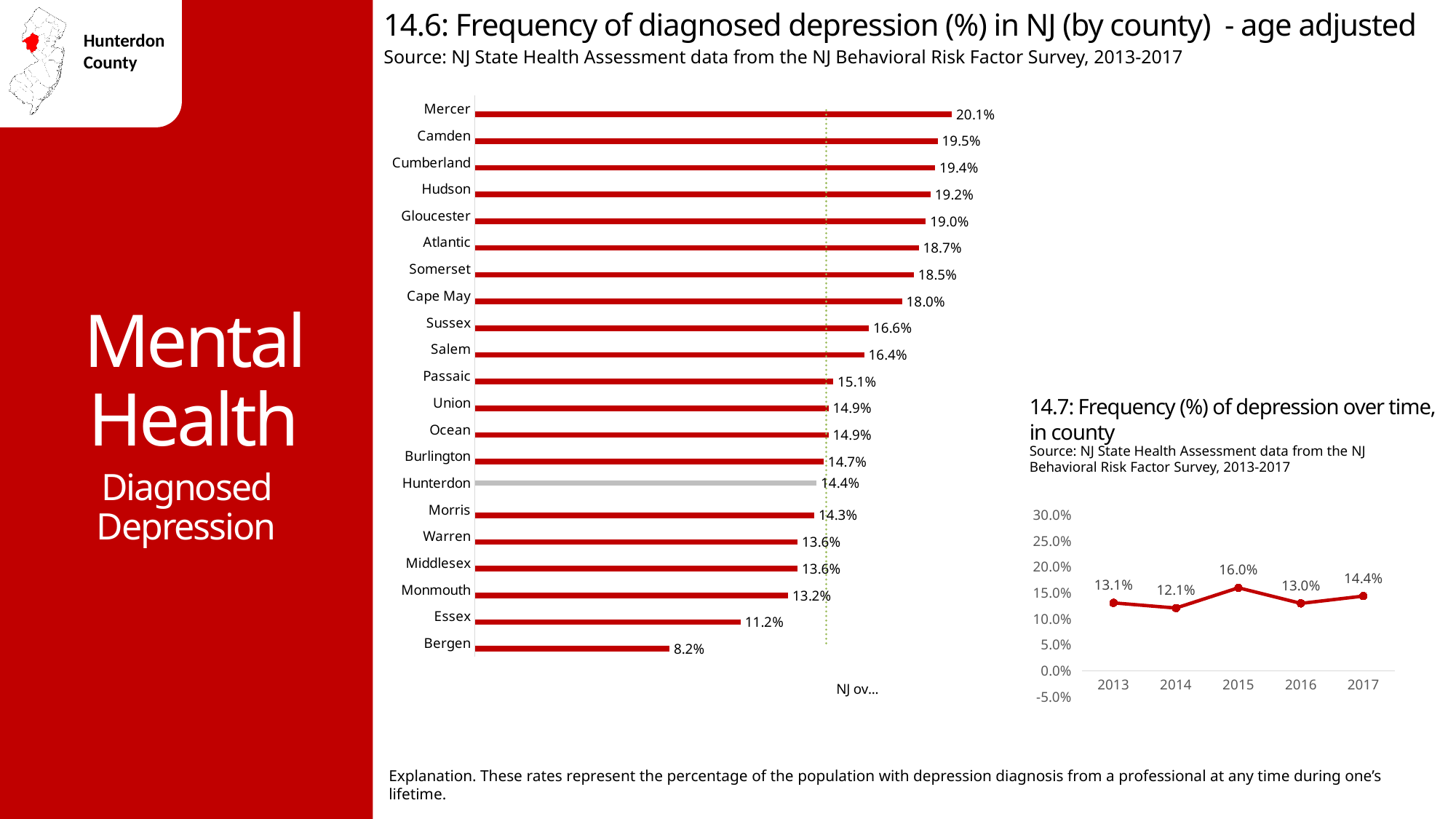
In chart 14.7 (frequency of depression over time), which year has the lowest value? 2014 In chart 14.7 (frequency of depression over time), what is the difference between 2017 and 2016? 1.4% In chart 14.6 (frequency of diagnosed depression by county), which county has the highest value? Mercer What kind of chart is chart 14.7 (frequency of depression over time)? Line chart What kind of chart is chart 14.6 (frequency of diagnosed depression by county)? Bar chart In chart 14.7 (frequency of depression over time), what is the value for 2015? 16.0% In chart 14.6 (frequency of diagnosed depression by county), which is larger, Sussex or Salem? Sussex In chart 14.6 (frequency of diagnosed depression by county), how many counties are plotted? 21 In chart 14.6 (frequency of diagnosed depression by county), what is the difference between Mercer and Bergen? 11.9% In chart 14.6 (frequency of diagnosed depression by county), what is the value for Essex? 11.2% In chart 14.6 (frequency of diagnosed depression by county), what is the value for Hunterdon? 14.4% In chart 14.6 (frequency of diagnosed depression by county), which county has the lowest value? Bergen